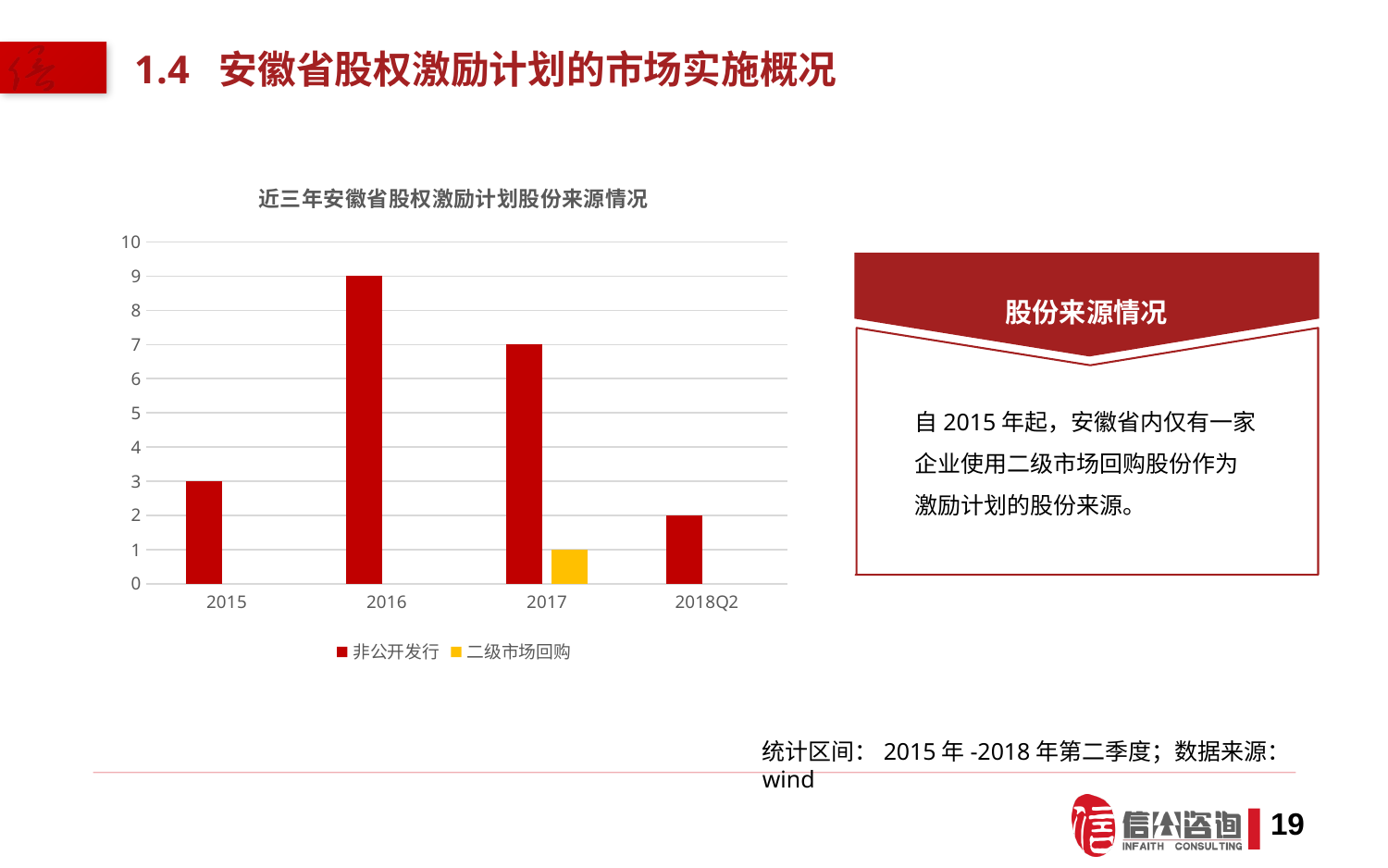
Which is larger, the 非公开发行 value for 2015 or for 2018Q2? 2015 How many series does the chart legend list? 2 What is the title of the chart? 近三年安徽省股权激励计划股份来源情况 What is the value of 非公开发行 for 2015? 3 What is the value of 二级市场回购 for 2017? 1 What is the value of 非公开发行 for 2016? 9 How many categories are shown on the x axis of the chart? 4 What kind of chart is shown on the slide? bar chart What is the difference between the 非公开发行 values for 2016 and 2017? 2 Which year has the highest value for 非公开发行? 2016 What is the value of 非公开发行 for 2017? 7 Which category has the lowest value for 非公开发行? 2018Q2